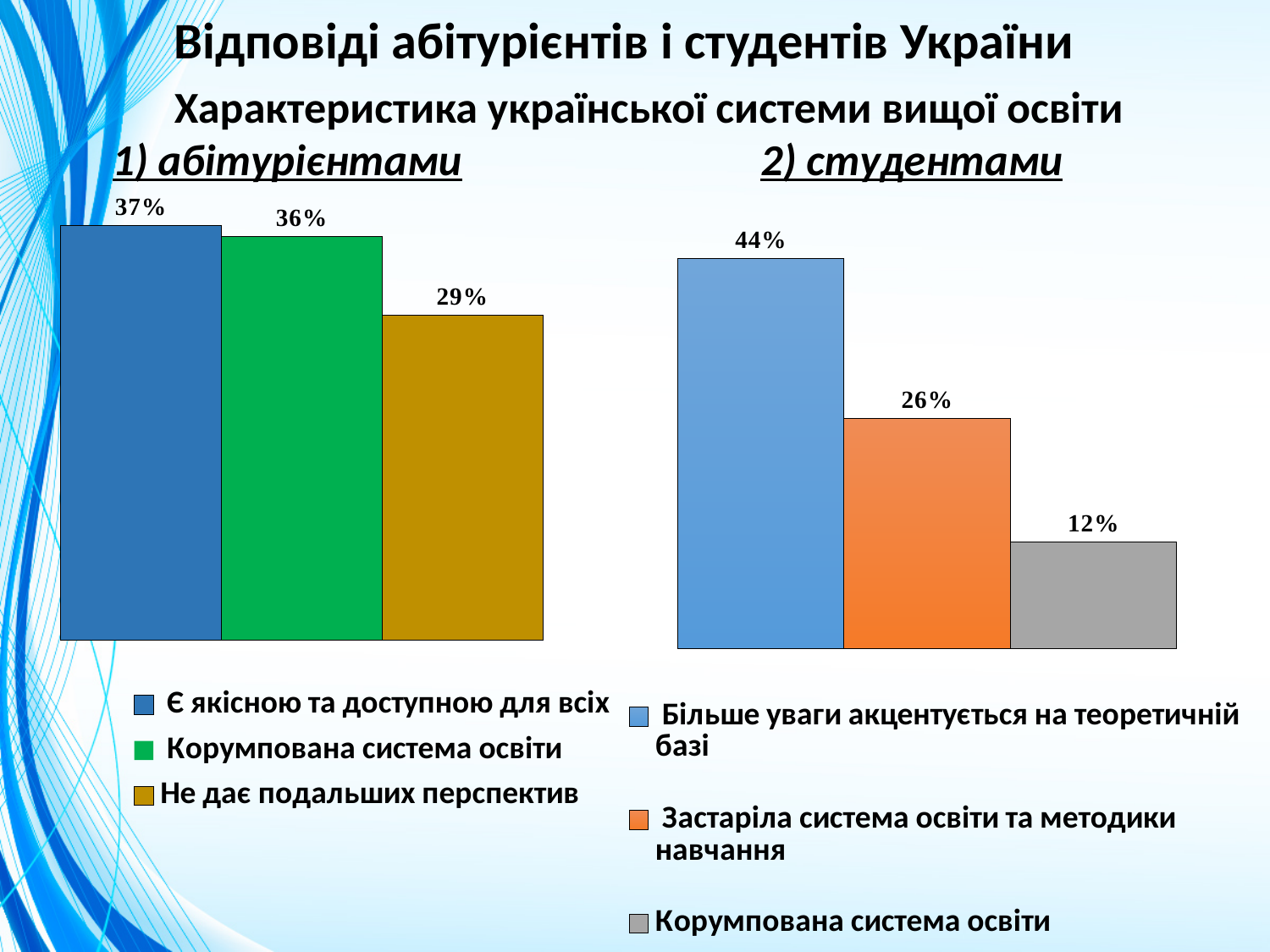
What type of chart is used on this slide? Bar chart In the right chart (2) студентами), what is the value for "Застаріла система освіти та методики навчання"? 26% How many bars are shown in the right chart (2) студентами)? 3 In the right chart (2) студентами), which category has the highest value? Більше уваги акцентується на теоретичній базі In the left chart (1) абітурієнтами), what is the difference between "Є якісною та доступною для всіх" and "Не дає подальших перспектив"? 8% In the left chart (1) абітурієнтами), what is the value for "Є якісною та доступною для всіх"? 37% How many legend entries does the left chart (1) абітурієнтами) list? 3 In the left chart (1) абітурієнтами), what is the value for "Не дає подальших перспектив"? 29% In the left chart (1) абітурієнтами), which category has the lowest value? Не дає подальших перспектив Which is larger: "Корумпована система освіти" in the left chart or "Корумпована система освіти" in the right chart? The left chart (36%) In the right chart (2) студентами), which category has the lowest value? Корумпована система освіти In the right chart (2) студентами), what is the difference between the highest and lowest values? 32%